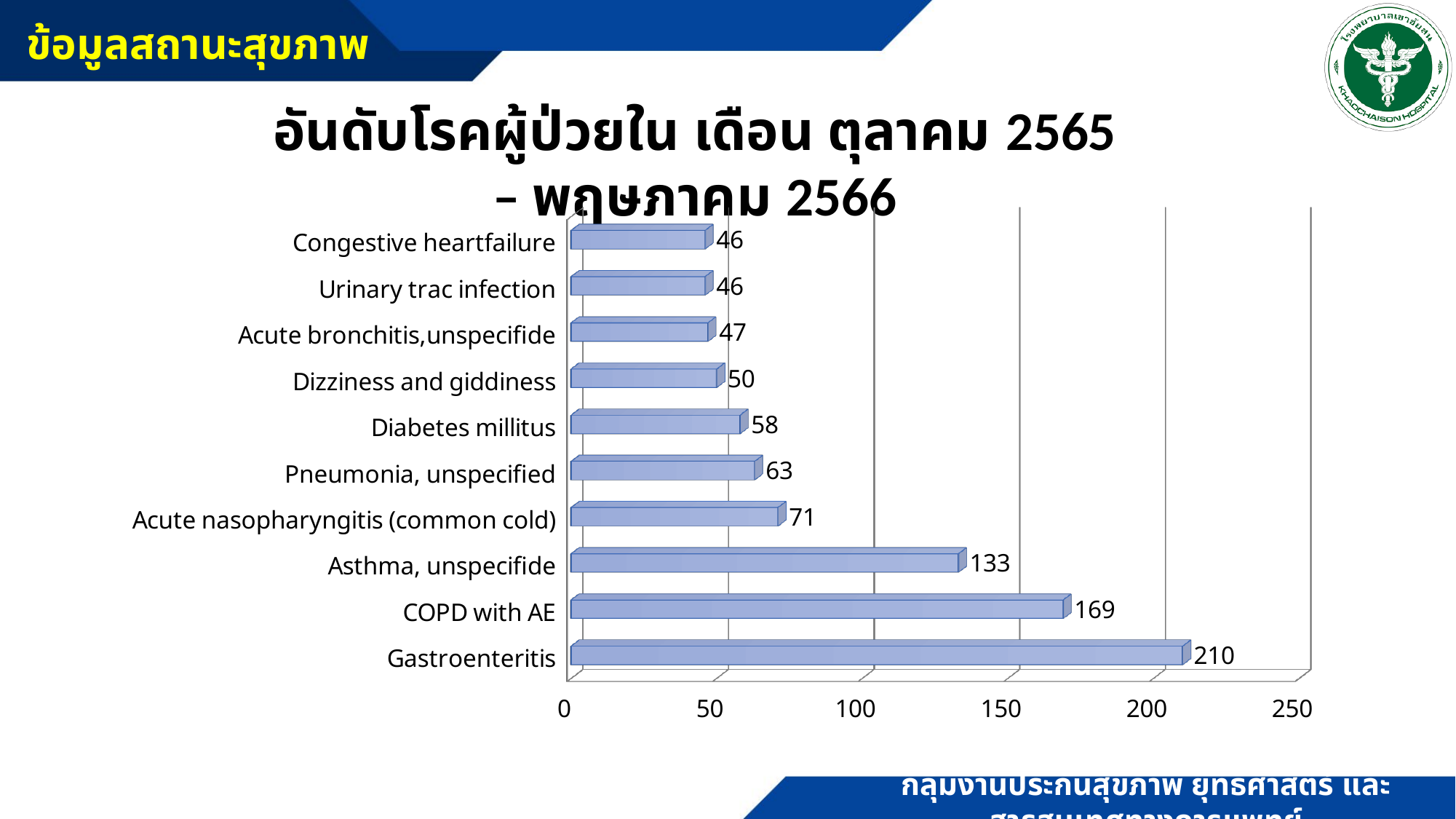
What is the highest value shown on the x axis? 250 Is the value for Asthma, unspecifide greater or less than 100? greater Which is larger, the value for Pneumonia, unspecified or the value for Dizziness and giddiness? Pneumonia, unspecified What is the value for Asthma, unspecifide? 133 What is the value for COPD with AE? 169 How many categories are shown in the chart? 10 Which category has the highest value? Gastroenteritis What is the value for Diabetes millitus? 58 What is the difference between the values for Acute nasopharyngitis (common cold) and Acute bronchitis,unspecifide? 24 What is the value for Gastroenteritis? 210 What kind of chart is shown on the slide? bar chart What is the difference between the values for Gastroenteritis and COPD with AE? 41